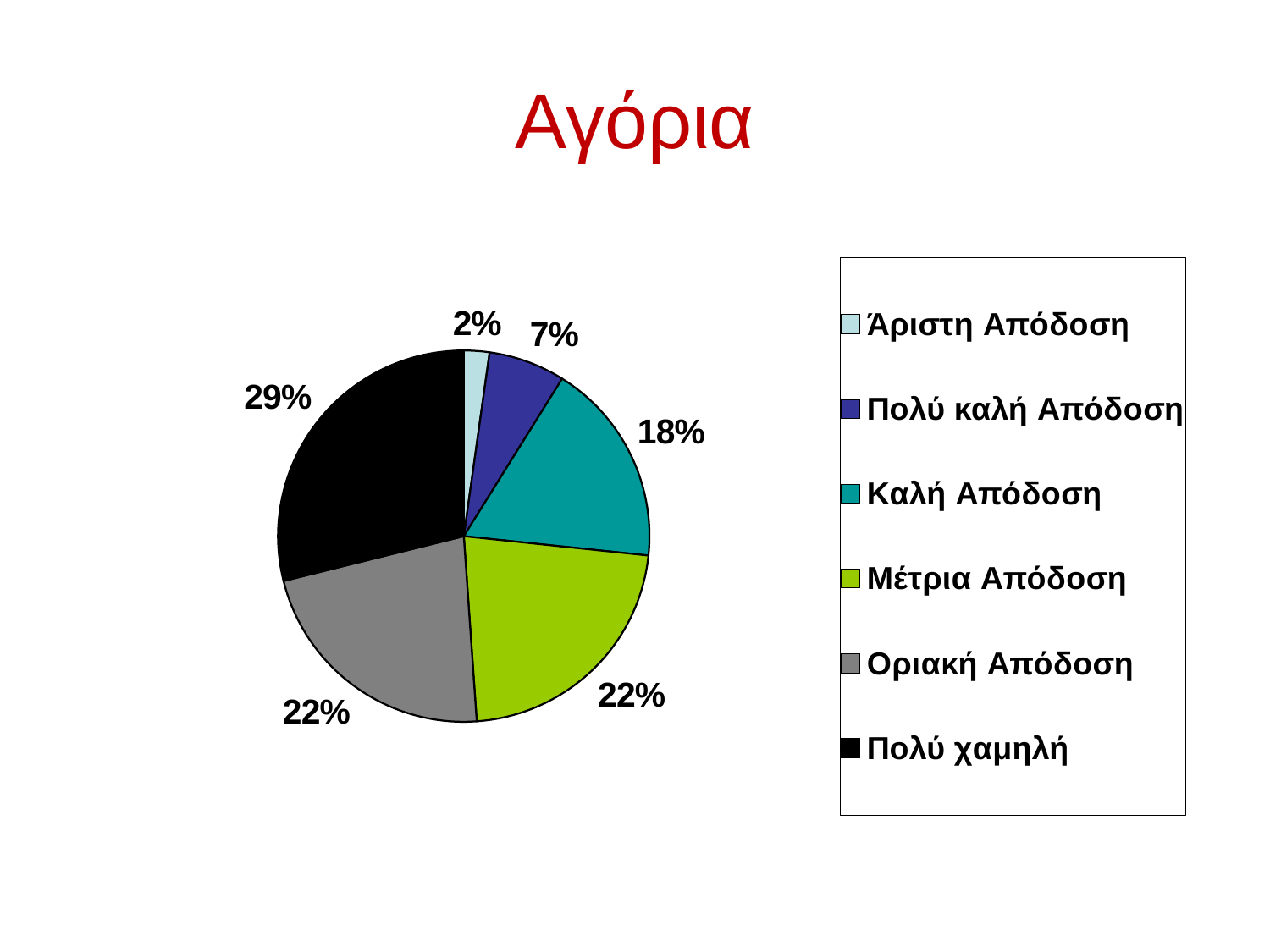
What percentage is shown for Άριστη Απόδοση? 2% What percentage is shown for Πολύ χαμηλή? 29% How many categories does the legend list? 6 Which category has the smallest share of the pie? Άριστη Απόδοση What is the title of the slide? Αγόρια What is the difference between the shares of Πολύ χαμηλή and Καλή Απόδοση? 11% What percentage is shown for Πολύ καλή Απόδοση? 7% What colour is the slice for Μέτρια Απόδοση? green What kind of chart is shown on the slide? pie chart What percentage is shown for Καλή Απόδοση? 18% Which is larger, the share for Καλή Απόδοση or the share for Πολύ καλή Απόδοση? Καλή Απόδοση Which category has the largest share of the pie? Πολύ χαμηλή